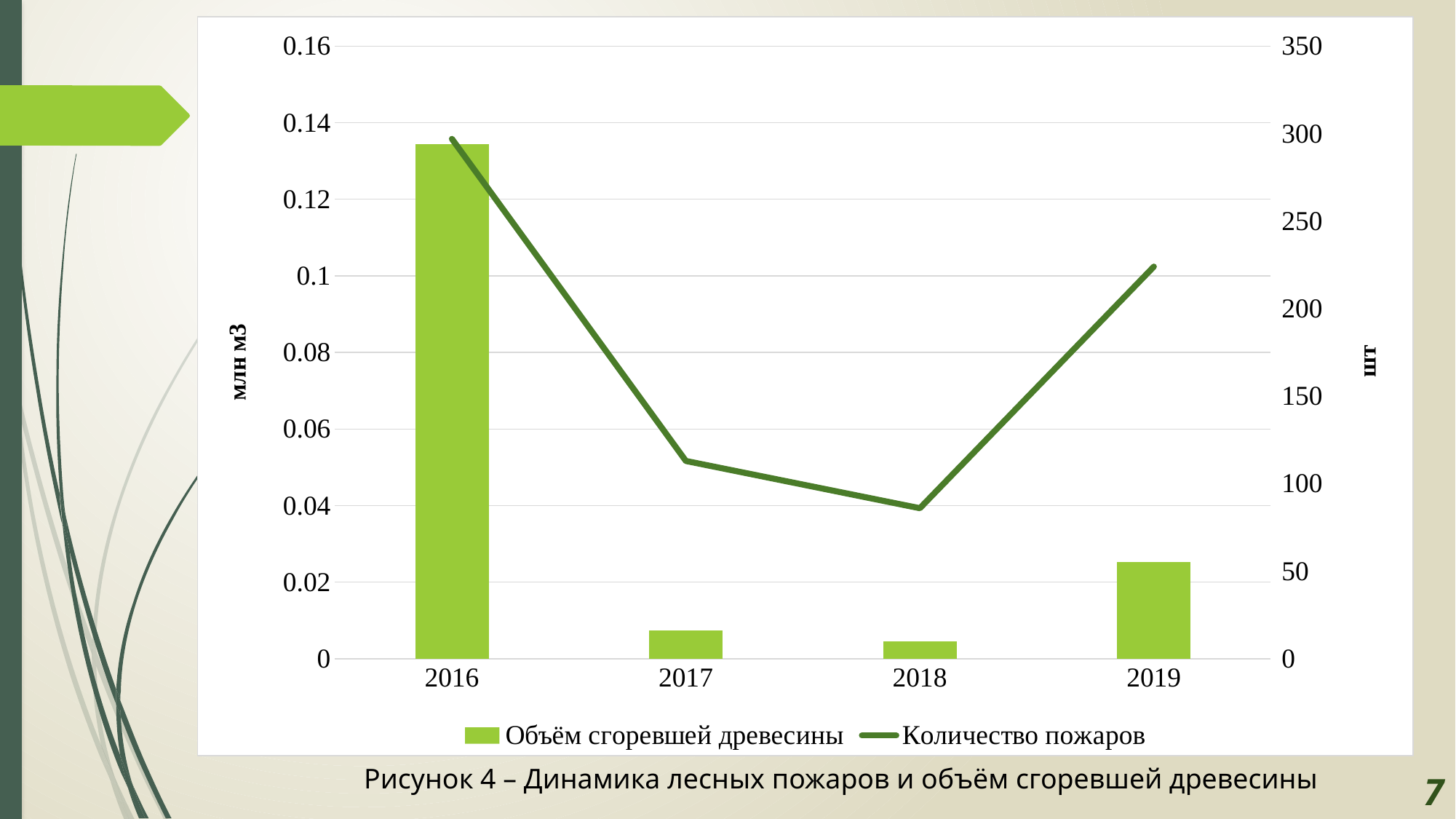
What kind of chart is shown on the slide? A combination bar and line chart What is the label on the right vertical axis of the chart? шт In which year is the line for Количество пожаров at its lowest? 2018 How many series does the chart legend list? 2 Is the value of Объём сгоревшей древесины for 2016 greater or less than 0.12? greater Is the value of Количество пожаров for 2019 greater or less than 200? greater How does the Количество пожаров line change from 2016 to 2019? It falls from 2016 to 2018, then rises in 2019 Which year has the larger bar for Объём сгоревшей древесины, 2017 or 2019? 2019 In which year is the line for Количество пожаров at its highest? 2016 In which year is the bar for Объём сгоревшей древесины the highest? 2016 How many years are shown on the x axis of the chart? 4 Is the value of Количество пожаров for 2018 greater or less than 100? less